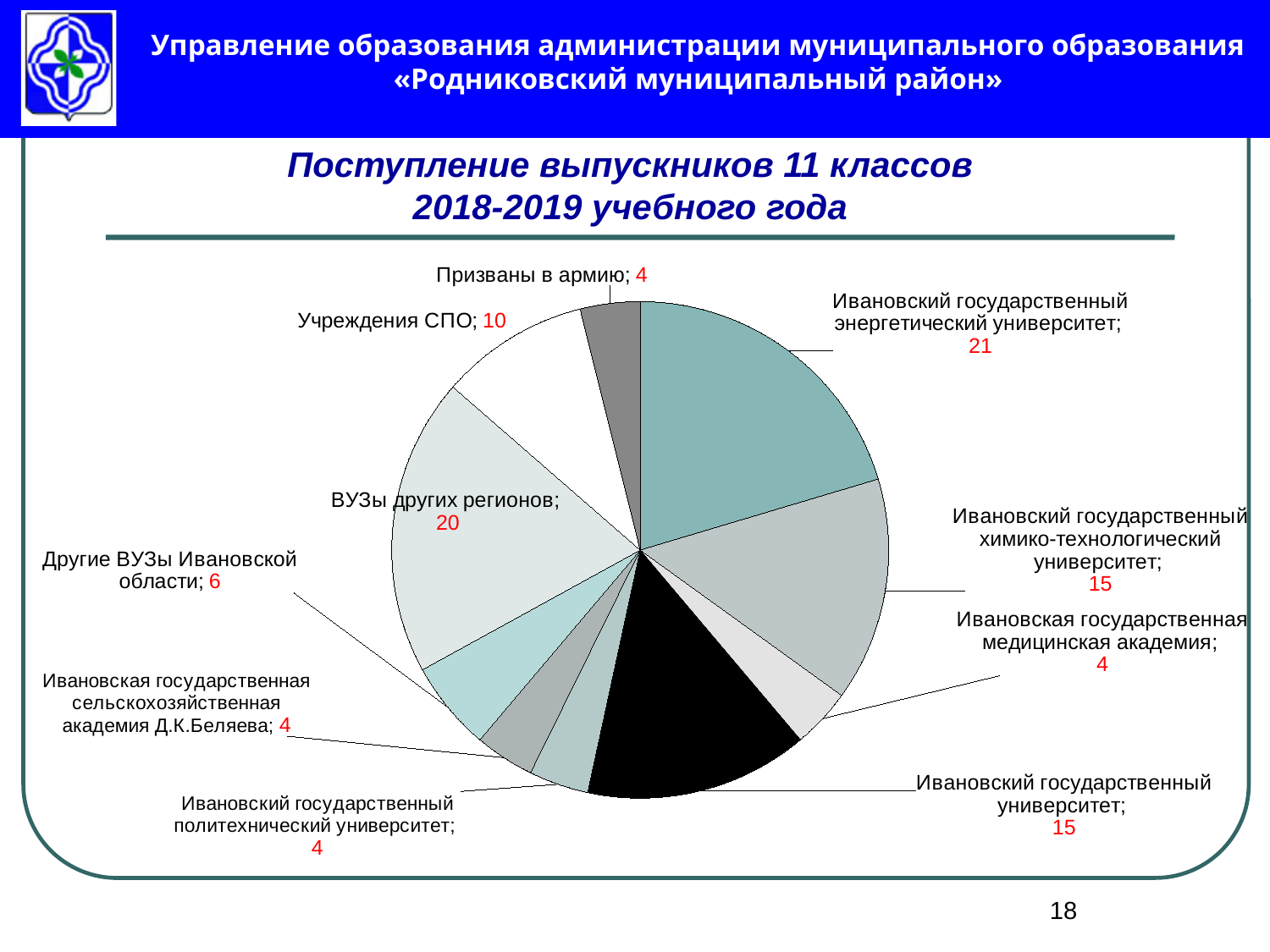
What is the value for Ивановский государственный химико-технологический университет? 15 What is the difference between the values for ВУЗы других регионов and Учреждения СПО? 10 What is the value for ВУЗы других регионов? 20 Which category has the largest slice of the pie? Ивановский государственный энергетический университет What type of chart is shown on the slide? Pie chart How many graduates entered Ивановский государственный энергетический университет? 21 How many categories does the pie chart show? 10 What is the value for Другие ВУЗы Ивановской области? 6 What is the value for Учреждения СПО? 10 Which is larger: the value for Ивановский государственный университет or the value for Другие ВУЗы Ивановской области? Ивановский государственный университет What is the difference between the values for Ивановский государственный энергетический университет and ВУЗы других регионов? 1 What is the title of the chart? Поступление выпускников 11 классов 2018-2019 учебного года